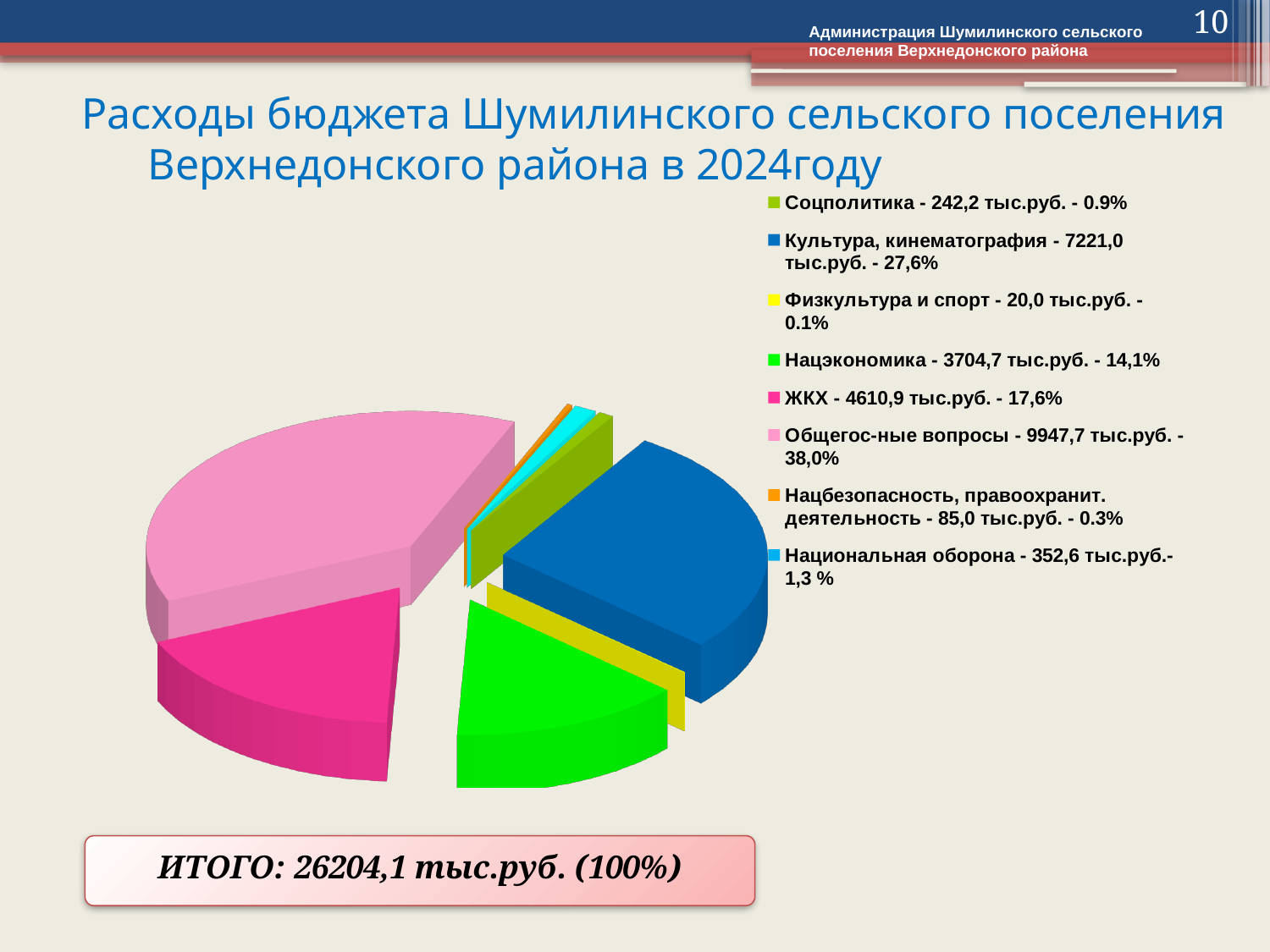
How many categories does the pie chart legend list? 8 What kind of chart is shown on the slide? Pie chart Which category has the largest share of expenses? Общегос-ные вопросы What is the value for Культура, кинематография? 7221,0 тыс.руб. Which is larger, ЖКХ or Нацэкономика? ЖКХ What is the value for ЖКХ? 4610,9 тыс.руб. Which category has the smallest share of expenses? Физкультура и спорт What percentage share does Нацэкономика have? 14,1% What colour represents Национальная оборона in the pie chart? Light blue What is the difference between Общегос-ные вопросы and Культура, кинематография in тыс.руб.? 2726,7 тыс.руб. What share of the budget expenses does Общегос-ные вопросы account for? 38,0% What is the total of all budget expenses shown on the slide? 26204,1 тыс.руб.